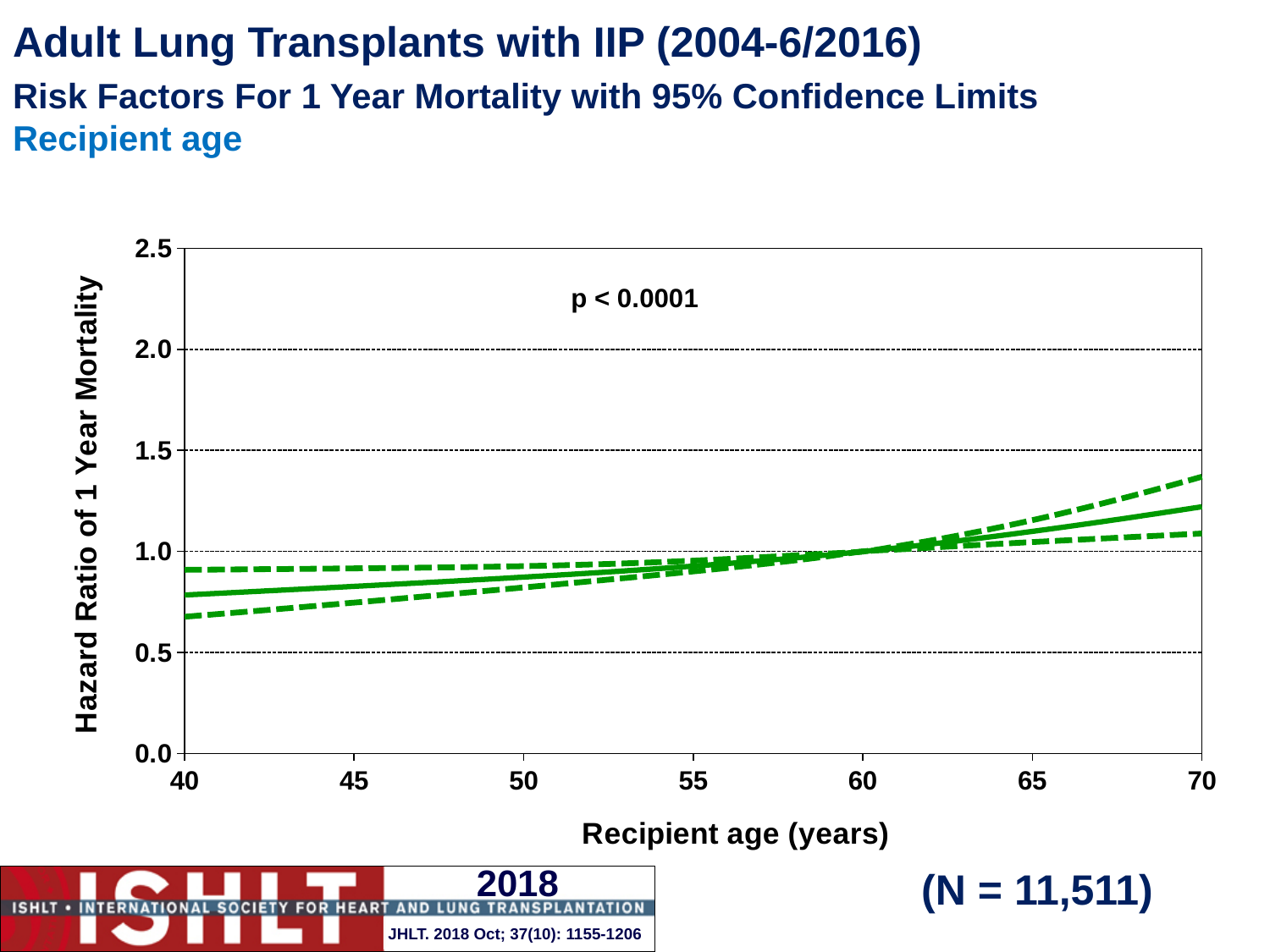
Which is larger, the hazard ratio at recipient age 45 or at recipient age 65? recipient age 65 Does the hazard ratio of 1 year mortality rise or fall as recipient age increases from 40 to 70 years? rise Is the hazard ratio (solid line) at recipient age 40 greater or less than 1.0? less Is the hazard ratio (solid line) at recipient age 70 greater or less than 1.5? less What kind of chart is shown on the slide? line chart What p-value is printed on the chart? p < 0.0001 What is the label of the x axis? Recipient age (years) How many lines are plotted on the chart? 3 Is the lower 95% confidence limit at recipient age 40 greater or less than 0.5? greater